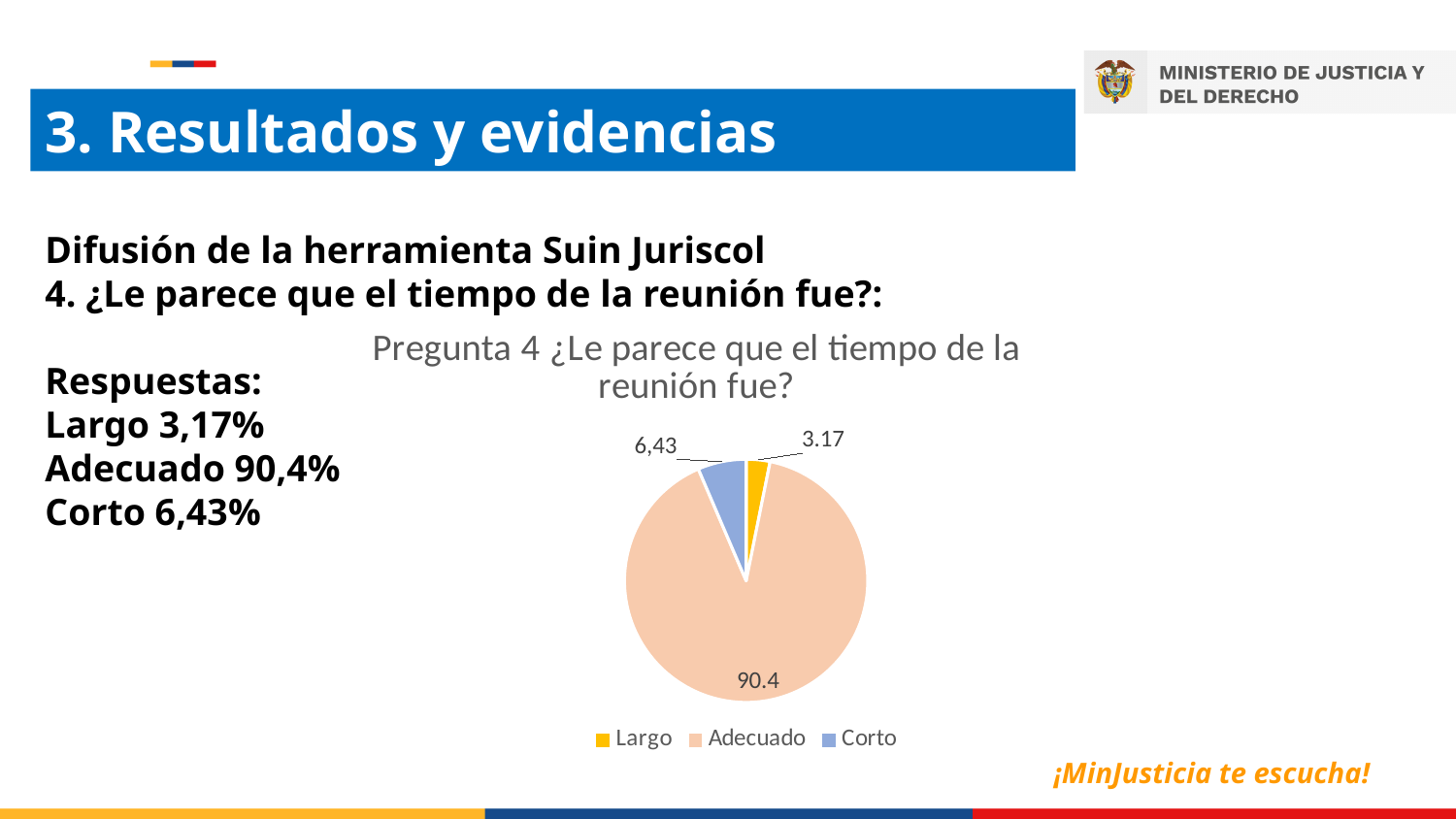
What is the title of the chart? Pregunta 4 ¿Le parece que el tiempo de la reunión fue? What value is shown for the Adecuado slice? 90.4 Which category has the smallest slice of the pie? Largo Which legend entry is shown in yellow? Largo How many entries does the chart legend list? 3 What kind of chart is shown on the slide? pie chart What is the difference between the Corto value and the Largo value? 3.26 How many slices does the pie chart have? 3 Which is larger, the Corto slice or the Largo slice? Corto What value is shown for the Largo slice? 3.17 What value is shown for the Corto slice? 6,43 Which category has the largest slice of the pie? Adecuado